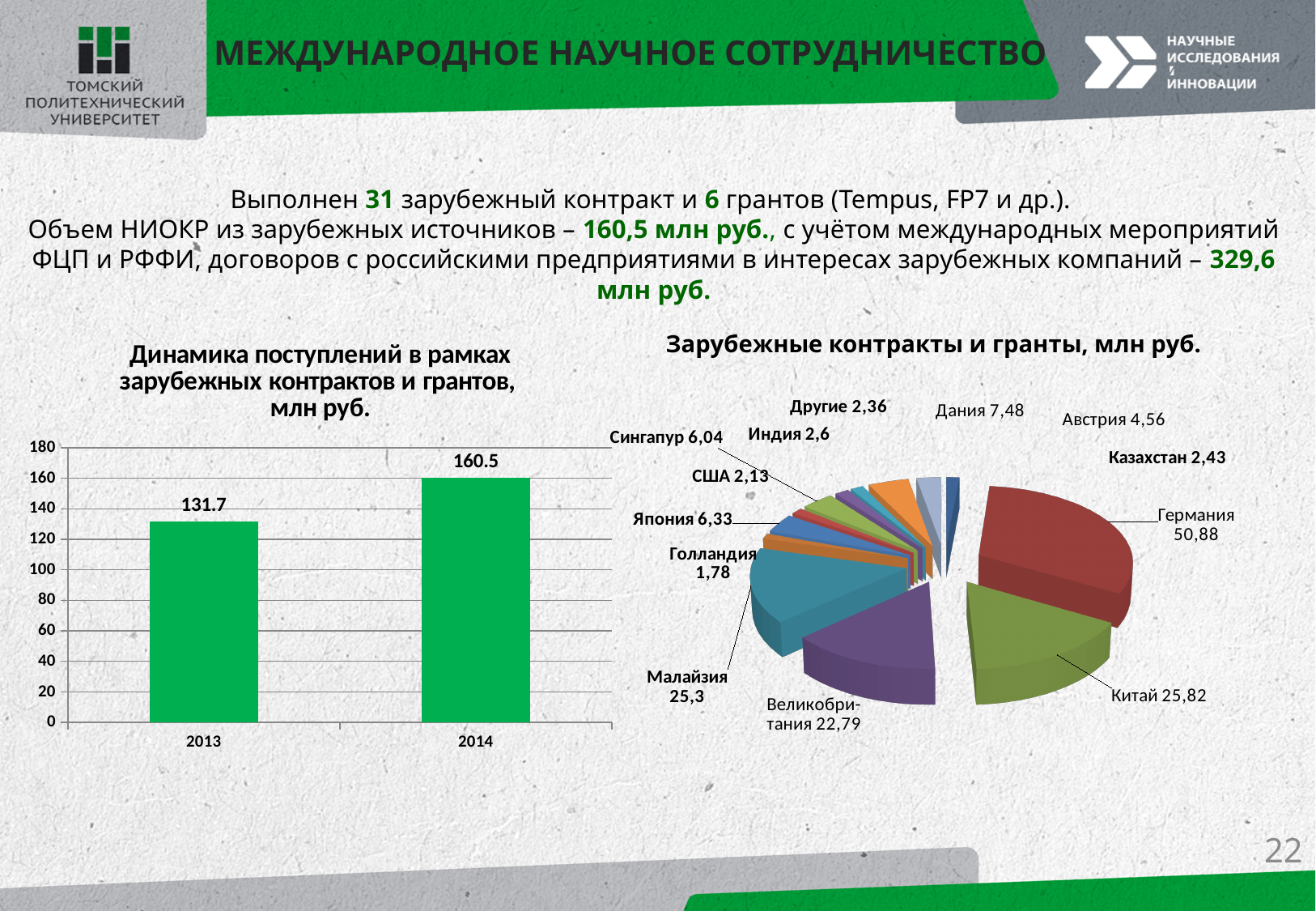
In the pie chart 'Зарубежные контракты и гранты, млн руб.', what is the difference between the values for Германия and Китай? 25,06 In the pie chart 'Зарубежные контракты и гранты, млн руб.', what is the value for Германия? 50,88 In the bar chart on the left, by how much did the value increase from 2013 to 2014? 28.8 In the pie chart 'Зарубежные контракты и гранты, млн руб.', which country has the smallest value? Голландия In the pie chart 'Зарубежные контракты и гранты, млн руб.', which country has the largest value? Германия What kind of chart is the chart on the left of the slide? bar chart In the bar chart 'Динамика поступлений в рамках зарубежных контрактов и грантов, млн руб.', what is the value for 2013? 131.7 In the pie chart 'Зарубежные контракты и гранты, млн руб.', which is larger: Малайзия or Великобритания? Малайзия How many categories (years) are shown in the bar chart on the left? 2 In the bar chart on the left, do the values rise or fall from 2013 to 2014? rise In the bar chart 'Динамика поступлений в рамках зарубежных контрактов и грантов, млн руб.', what is the value for 2014? 160.5 How many slices does the pie chart 'Зарубежные контракты и гранты, млн руб.' have? 13